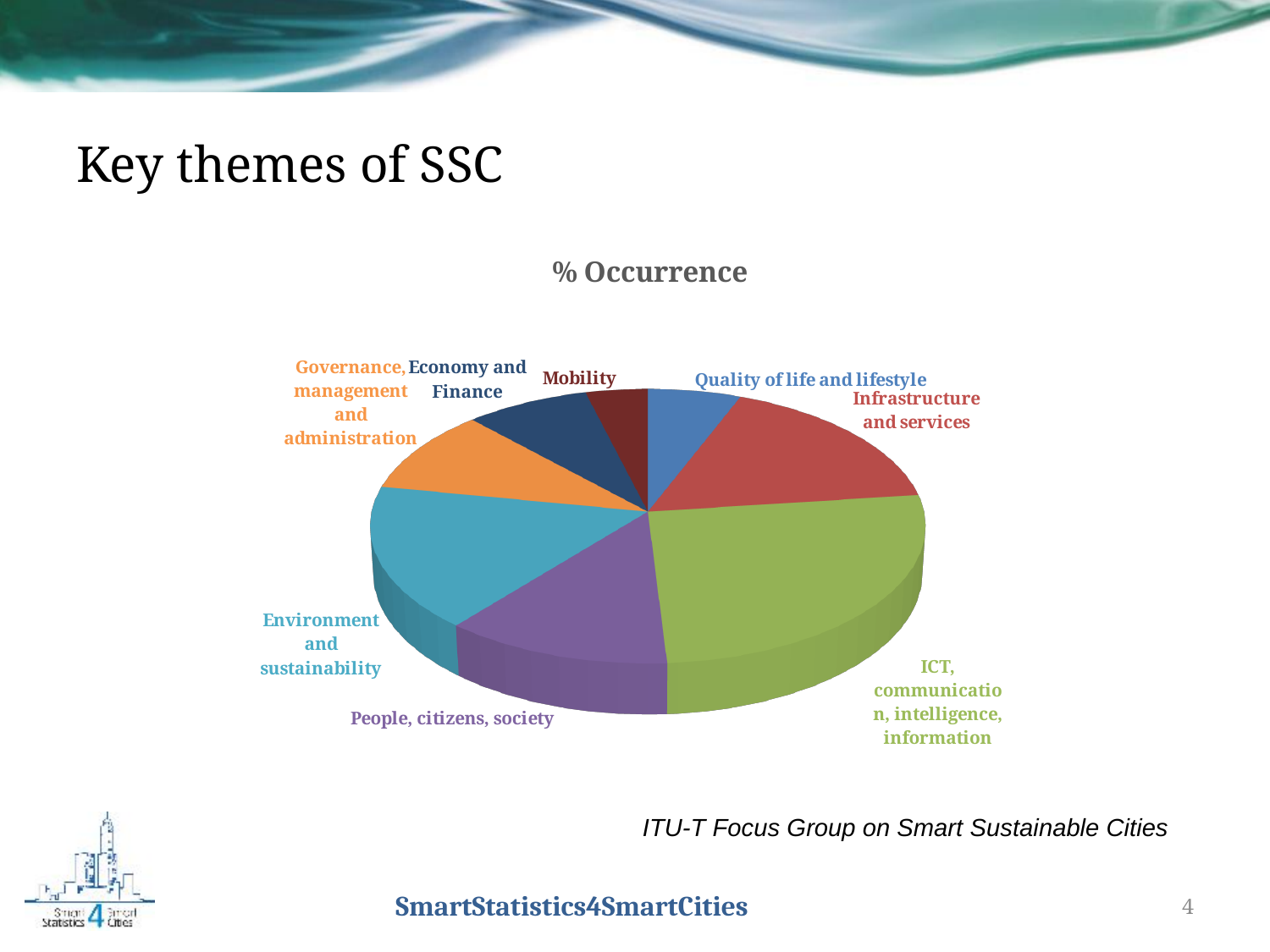
What colour is the slice for ICT, communication, intelligence, information? green Which category has the largest slice of the pie? ICT, communication, intelligence, information Which slice is larger: Environment and sustainability or Governance, management and administration? Environment and sustainability What is the title of the chart? % Occurrence What kind of chart is shown on the slide? pie chart Which slice is larger: People, citizens, society or Mobility? People, citizens, society Which slice is larger: People, citizens, society or Economy and Finance? People, citizens, society How many categories (slices) does the pie chart have? 8